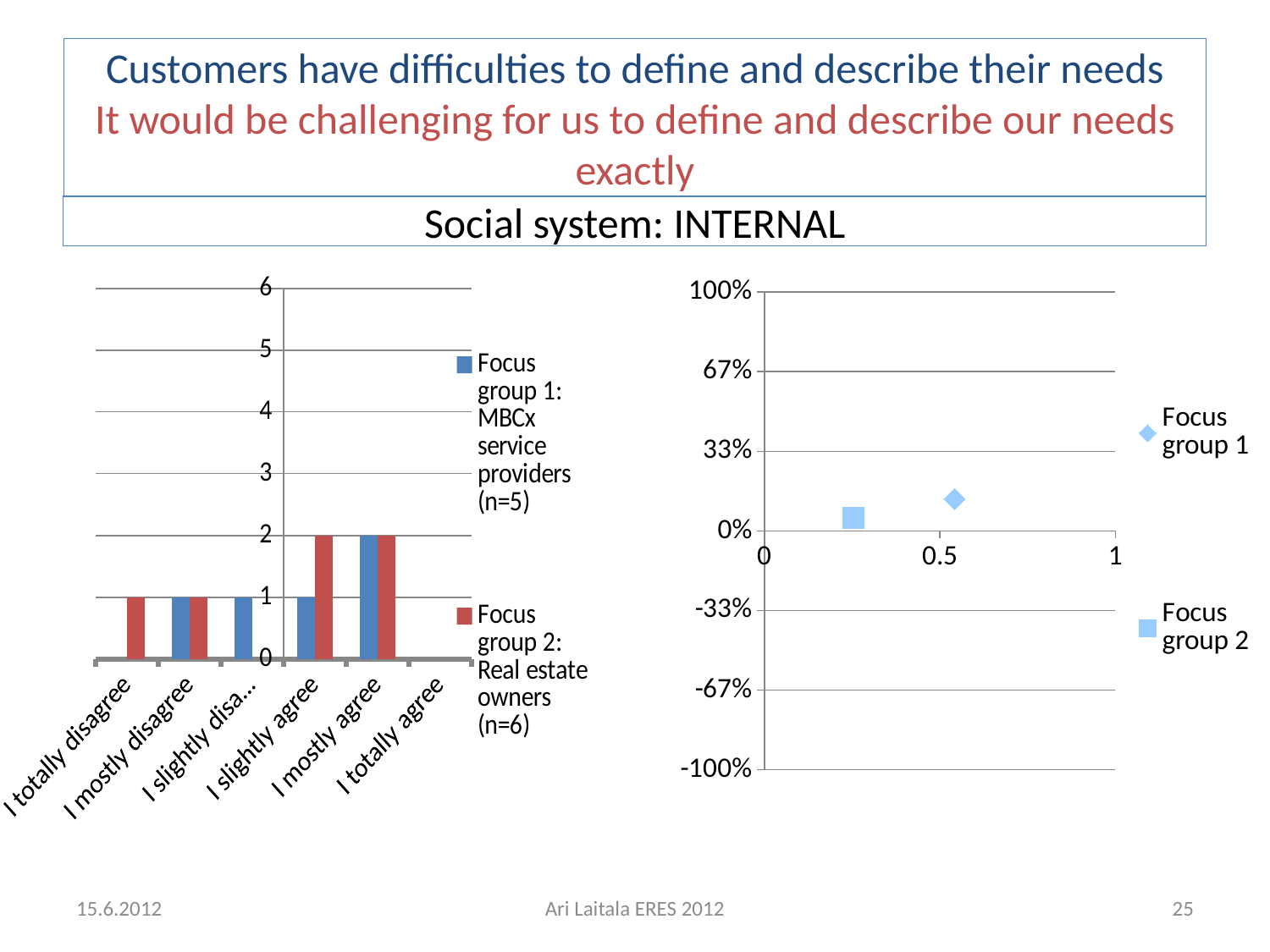
What kind of chart is the chart on the right of the slide? scatter chart In the bar chart on the left, what is the value for Focus group 2: Real estate owners (n=6) for 'I totally disagree'? 1 In the bar chart on the left, what is the difference between Focus group 2 and Focus group 1 for 'I slightly agree'? 1 In the bar chart on the left, what is the value for Focus group 1: MBCx service providers (n=5) for 'I mostly agree'? 2 In the bar chart on the left, what is the value for Focus group 2: Real estate owners (n=6) for 'I slightly agree'? 2 What kind of chart is the chart on the left of the slide? bar chart In the scatter chart on the right, how many series does the legend list? 2 In the bar chart on the left, how many response categories are shown on the x axis? 6 In the bar chart on the left, how many series does the legend list? 2 In the scatter chart on the right, is the vertical value of the Focus group 1 point greater or less than 33%? less In the bar chart on the left, for 'I slightly agree', which series has the larger value? Focus group 2: Real estate owners (n=6) In the bar chart on the left, which category has the highest value for Focus group 1: MBCx service providers (n=5)? I mostly agree